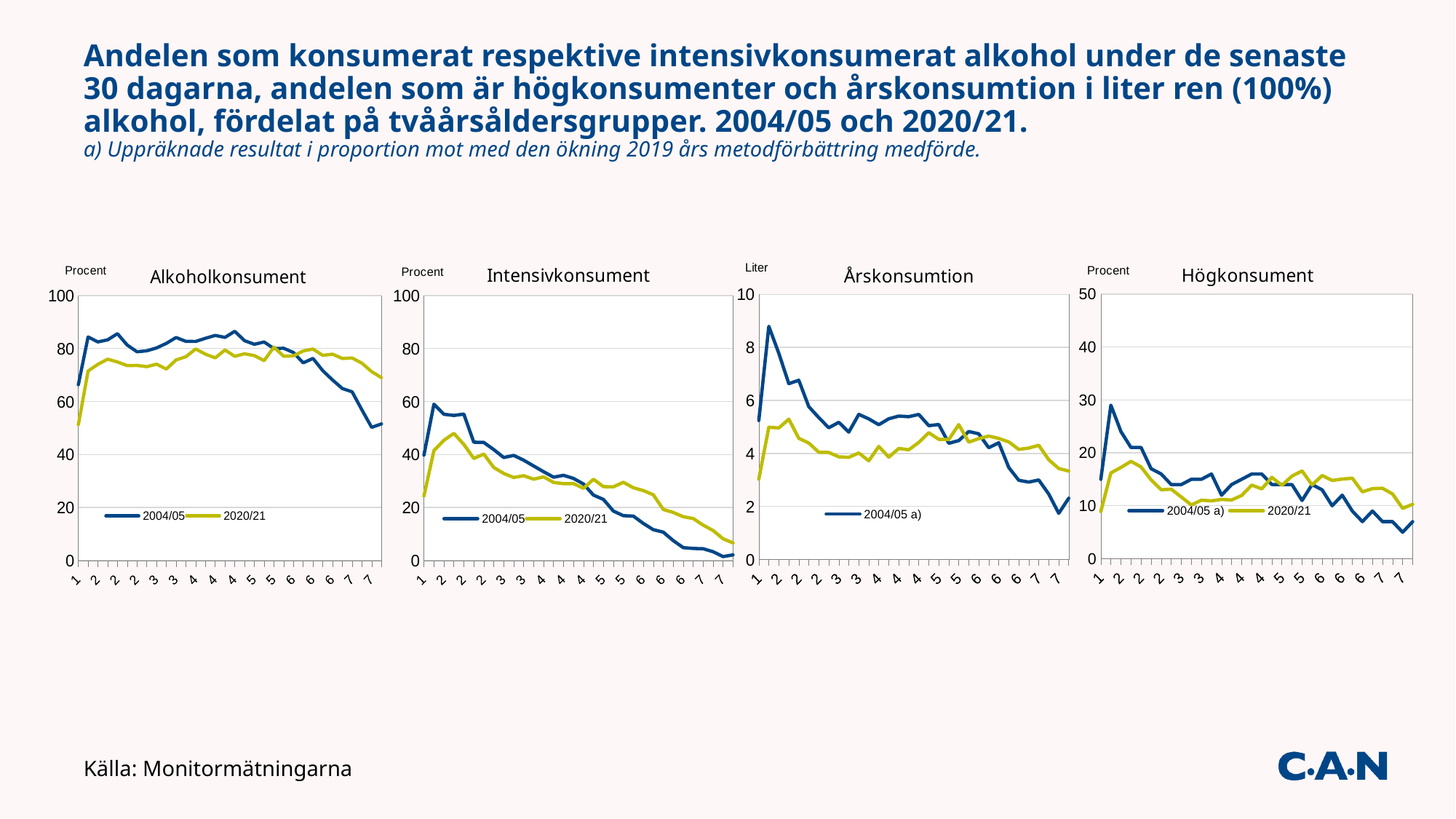
In the "Årskonsumtion" chart, is the highest value of the 2004/05 a) series greater or less than 8? greater In the "Högkonsument" chart, is the highest value of the 2004/05 a) series greater or less than 20? greater In the "Intensivkonsument" chart, do the values of the 2004/05 series generally rise or fall along the x axis? fall In the "Intensivkonsument" chart, which series has the larger value at the first point on the x axis, 2004/05 or 2020/21? 2004/05 How many series does the legend of the "Årskonsumtion" chart list? 1 What kind of chart is the "Alkoholkonsument" chart? line chart In the "Intensivkonsument" chart, is the highest value of the 2004/05 series greater or less than 50? greater In the "Alkoholkonsument" chart, which series has the larger value at the last point on the x axis, 2004/05 or 2020/21? 2020/21 What unit is shown on the y axis of the "Årskonsumtion" chart? Liter What is the maximum value shown on the y axis of the "Högkonsument" chart? 50 How many series does the legend of the "Intensivkonsument" chart list? 2